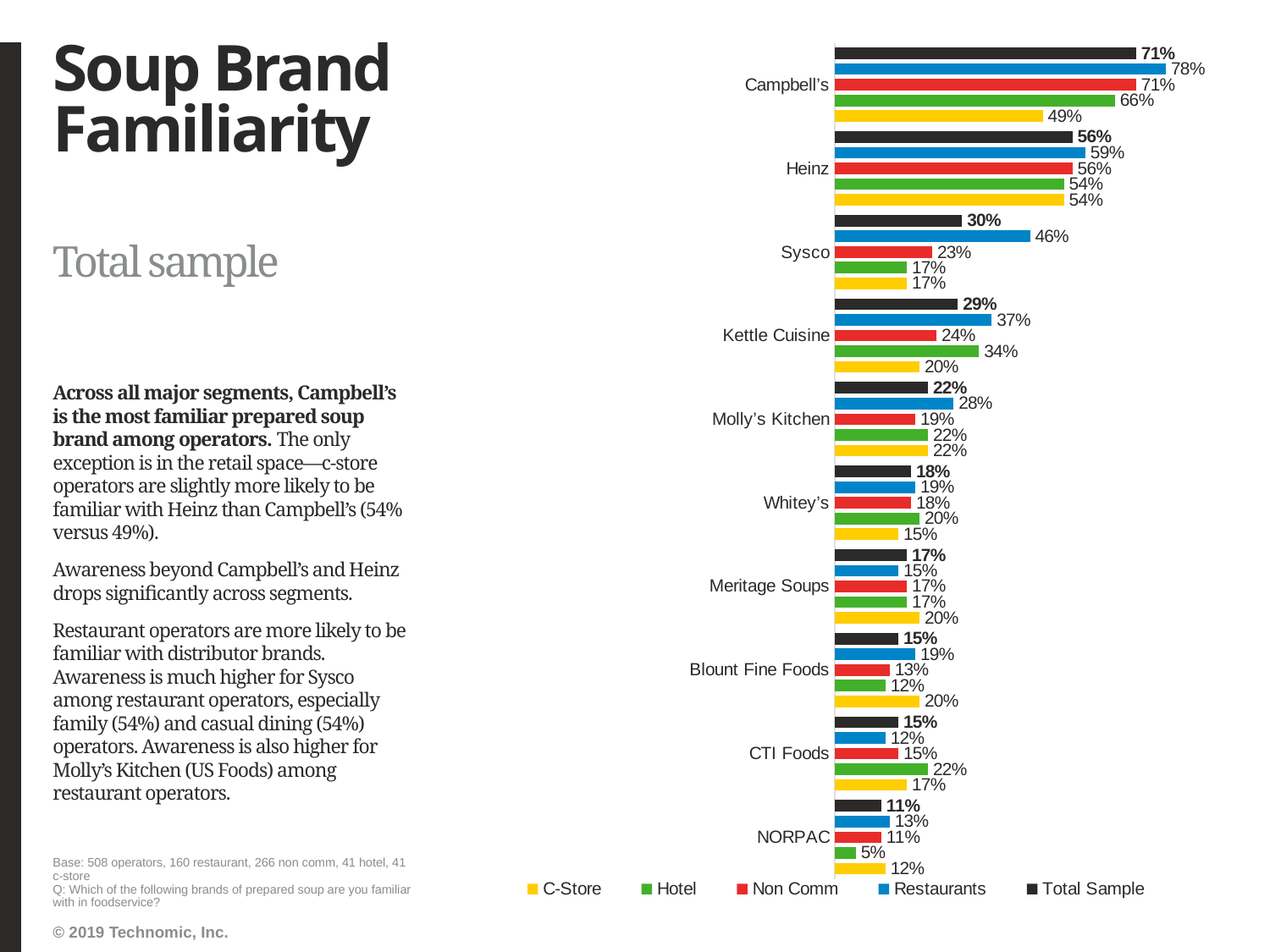
Which brand has the highest Total Sample familiarity? Campbell's How many series does the legend list? 5 For Kettle Cuisine, which segment has the higher value: Hotel or Non Comm? Hotel Which brand has the lowest Total Sample familiarity? NORPAC What is the Hotel value for NORPAC? 5% What is the C-Store value for Heinz? 54% What is the difference between the Restaurants and C-Store values for Campbell's? 29% Which colour represents the Non Comm series in the chart? Red What is the Total Sample familiarity value for Campbell's? 71% What percentage of Restaurants operators are familiar with Sysco? 46% How many brands are shown in the chart? 10 What type of chart is shown on the slide? Bar chart